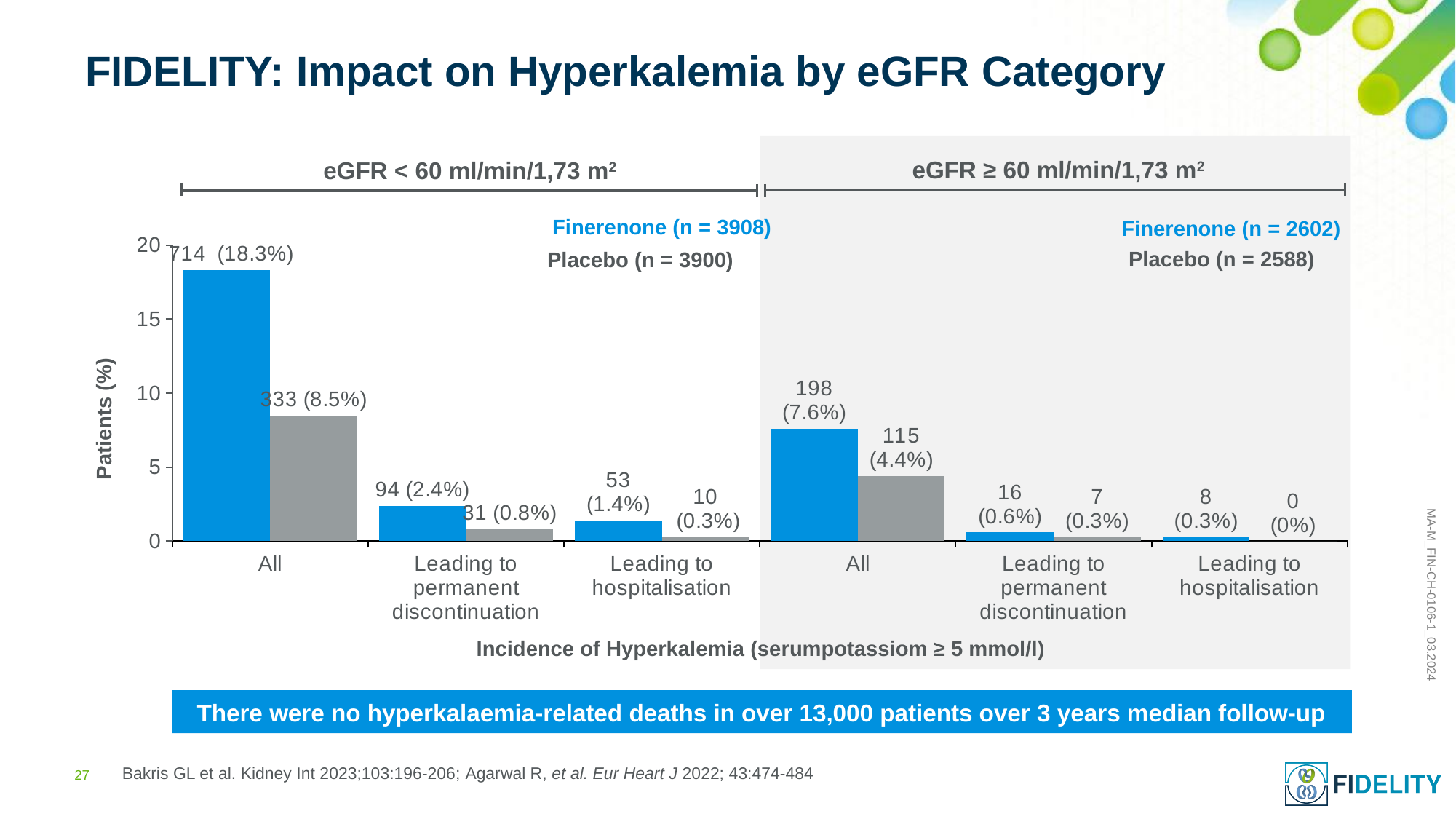
Is the finerenone 'All' value for eGFR ≥ 60 ml/min/1,73 m² greater or less than 10%? less In the eGFR ≥ 60 ml/min/1,73 m² group, which is larger for the 'All' category: finerenone or placebo? Finerenone What is the number of finerenone patients in the eGFR ≥ 60 ml/min/1,73 m² group according to the legend? 2602 What is the difference in percentage points between finerenone and placebo for the 'All' category in the eGFR < 60 ml/min/1,73 m² group? 9.8 percentage points What is the label of the y-axis of the chart? Patients (%) Which bar in the chart is the highest? Finerenone, All, eGFR < 60 ml/min/1,73 m² (18.3%) What type of chart is shown on the slide? Bar chart How many placebo patients with eGFR ≥ 60 ml/min/1,73 m² had hyperkalemia leading to hospitalisation? 0 What percentage of finerenone patients with eGFR < 60 ml/min/1,73 m² had any hyperkalemia (the 'All' category)? 18.3% How many placebo patients with eGFR < 60 ml/min/1,73 m² had hyperkalemia in the 'All' category? 333 How many series does the chart show? 2 What percentage of finerenone patients with eGFR ≥ 60 ml/min/1,73 m² had hyperkalemia leading to hospitalisation? 0.3%